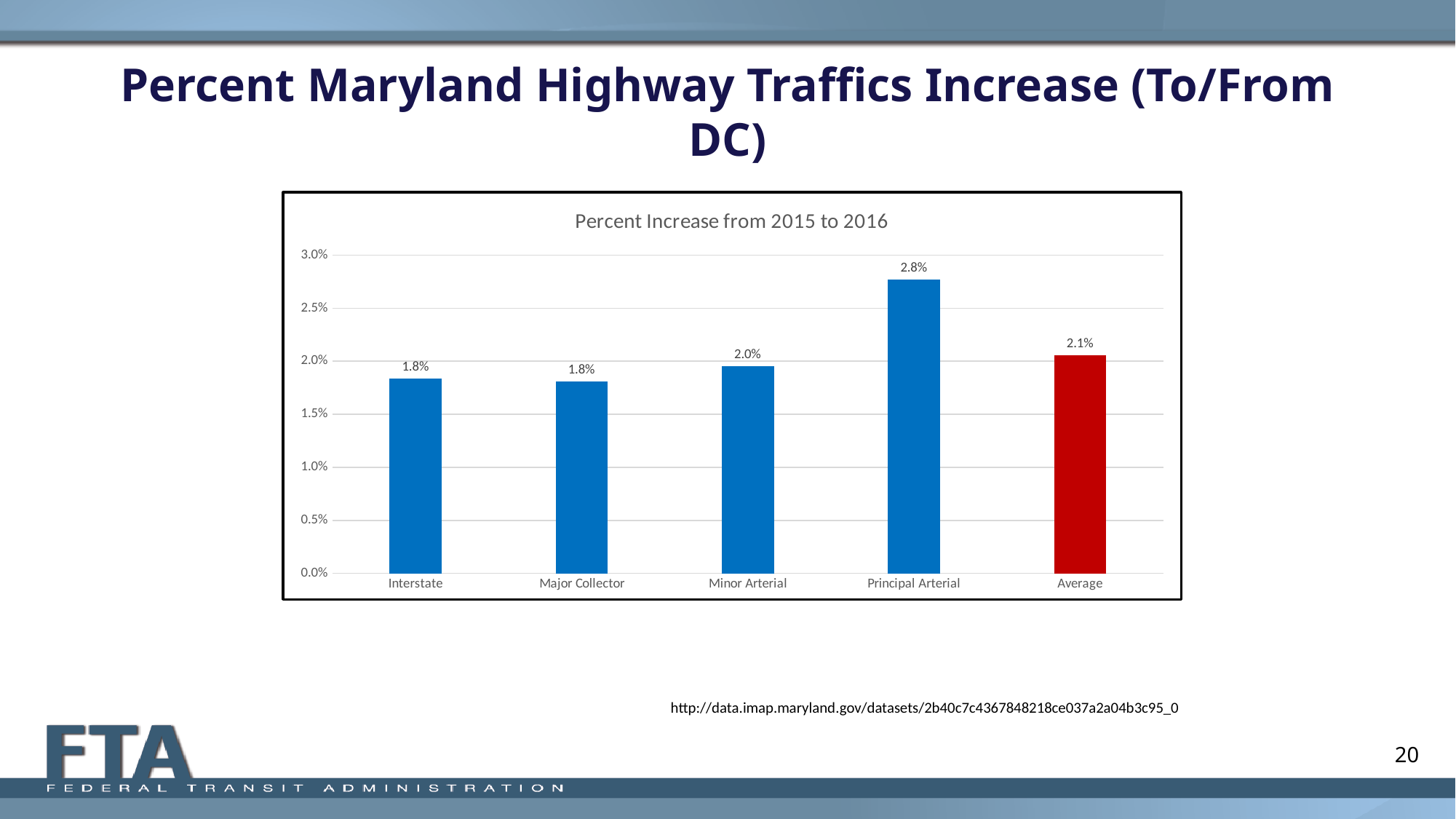
What kind of chart is shown on the slide? bar chart What is the percent increase for Minor Arterial? 2.0% What is the difference between the Principal Arterial value and the Minor Arterial value? 0.8% How many categories are shown on the x axis? 5 Is the value for Principal Arterial greater or less than 2.5%? greater What is the percent increase for Principal Arterial? 2.8% What value is shown for the Average bar? 2.1% Which is larger, the value for Principal Arterial or the value for Average? Principal Arterial What is the title printed inside the chart? Percent Increase from 2015 to 2016 Which category has the highest percent increase? Principal Arterial Which is larger, the value for Minor Arterial or the value for Major Collector? Minor Arterial What is the percent increase for Interstate? 1.8%